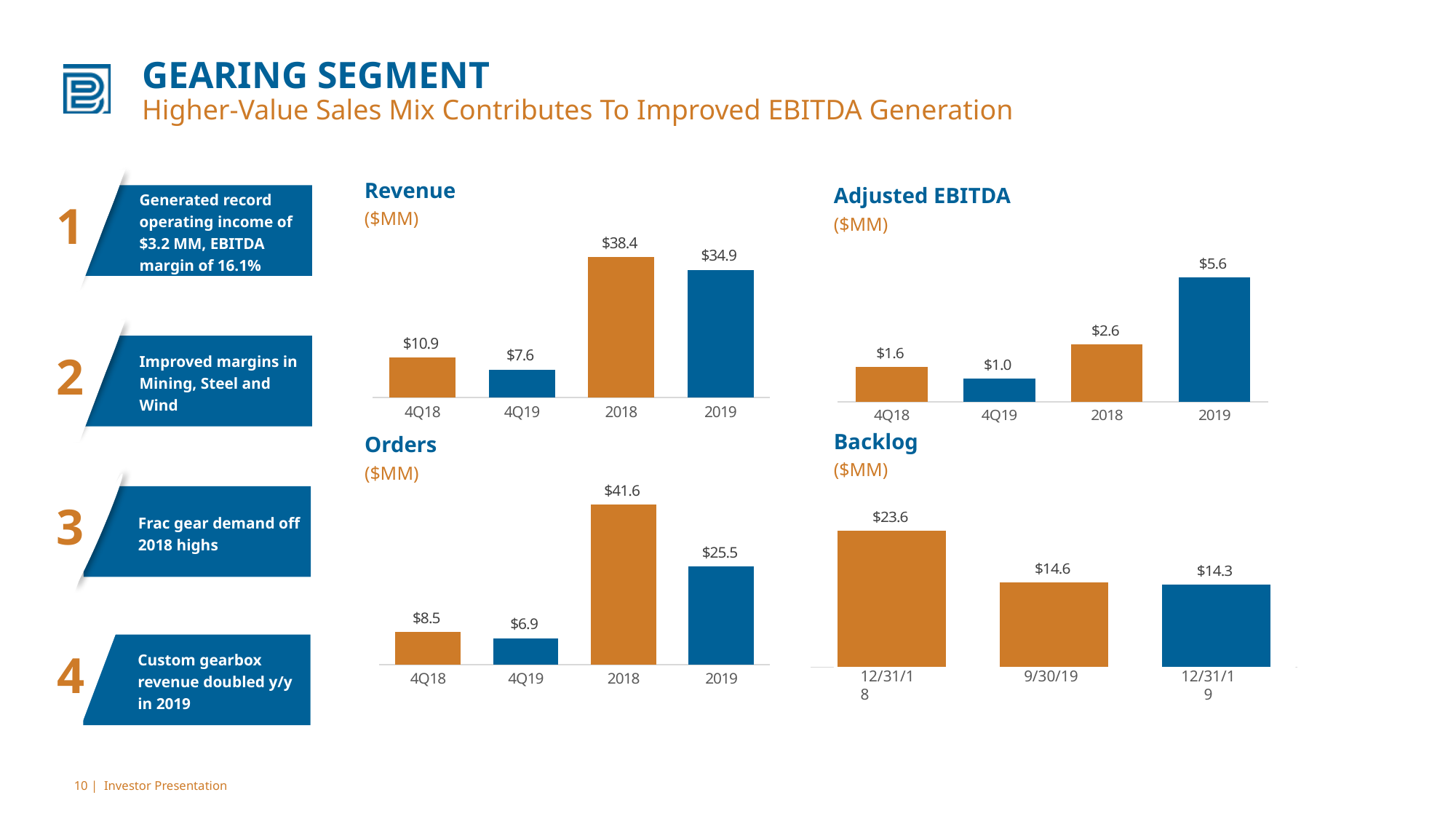
In the Backlog chart, how many bars are plotted? 3 In the Backlog chart, which date has the highest value? 12/31/18 What type of chart is the Adjusted EBITDA chart? bar chart In the Orders chart, what is the value for 4Q19? $6.9 In the Orders chart, which category has the highest value? 2018 In the Revenue chart, is the value for 4Q18 larger or smaller than the value for 4Q19? larger In the Adjusted EBITDA chart, what is the difference between the 2019 and 2018 values? $3.0 In the Backlog chart, what is the value for 9/30/19? $14.6 In the Orders chart, what is the difference between the 4Q18 and 4Q19 values? $1.6 In the Adjusted EBITDA chart, what is the value for 2019? $5.6 In the Revenue chart, what is the value for 2018? $38.4 In the Revenue chart, which category has the lowest value? 4Q19